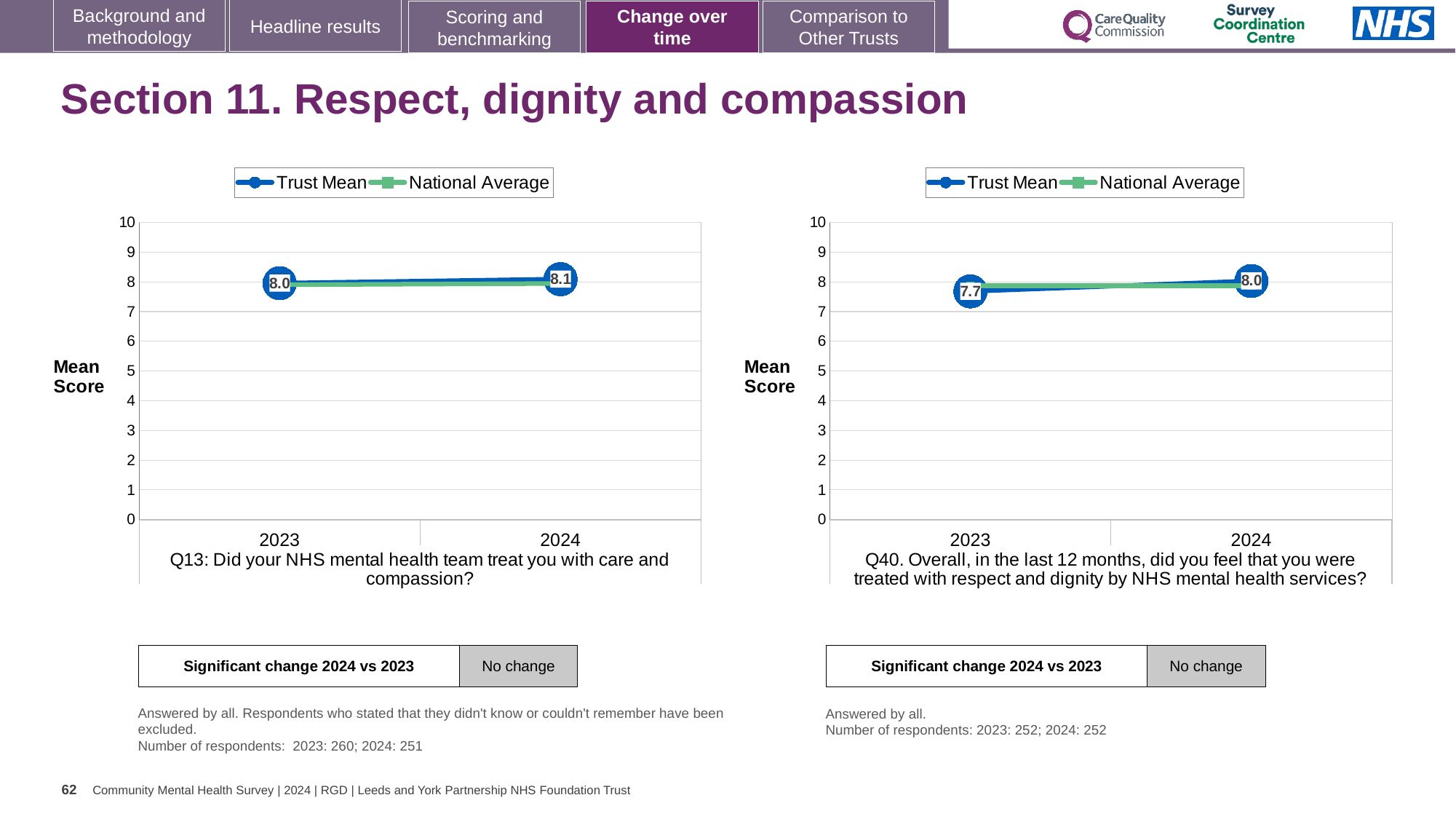
What is the y-axis label on the right chart (Q40)? Mean Score On the right chart (Q40), what is the Trust Mean for 2024? 8.0 On the left chart (Q13), what is the Trust Mean for 2023? 8.0 On the left chart (Q13), does the Trust Mean rise or fall from 2023 to 2024? rise On the left chart (Q13), what is the Trust Mean for 2024? 8.1 On the right chart (Q40), by how much did the Trust Mean change from 2023 to 2024? 0.3 How many years are plotted on the x axis of the left chart (Q13)? 2 How many series does the legend of the right chart (Q40) list? 2 What kind of chart is the left chart (Q13)? line chart On the right chart (Q40), what is the Trust Mean for 2023? 7.7 On the left chart (Q13), is the National Average for 2024 greater or less than 5? greater On the right chart (Q40), which year has the higher Trust Mean, 2023 or 2024? 2024